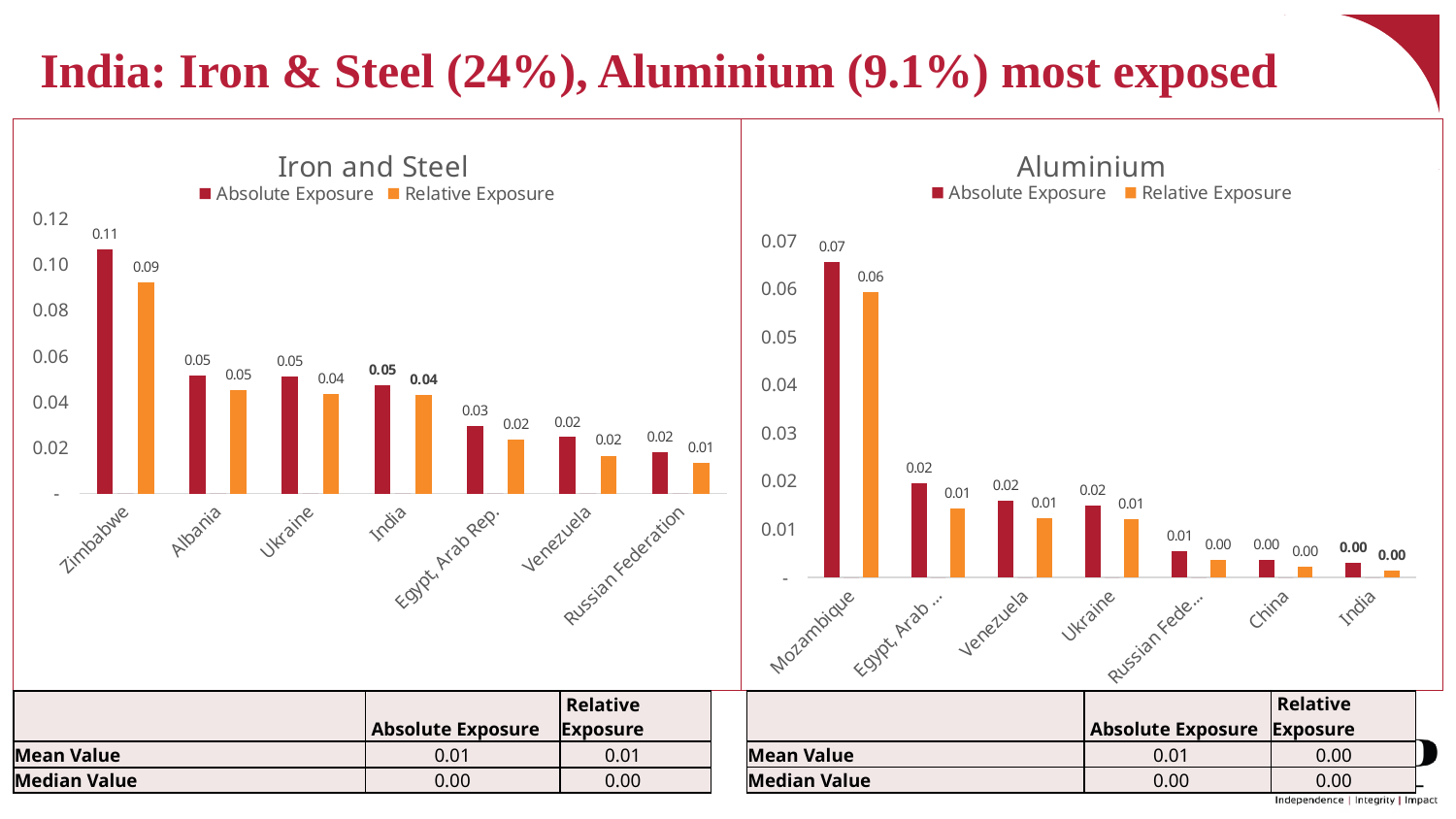
In the Aluminium chart, which is larger: Mozambique's Absolute Exposure or Egypt's Absolute Exposure? Mozambique's Absolute Exposure In the Iron and Steel chart, which country has the lowest Relative Exposure? Russian Federation In the Aluminium chart, what is the Relative Exposure value for Ukraine? 0.01 In the Iron and Steel chart, is the Absolute Exposure value for Zimbabwe greater or less than 0.10? greater In the Aluminium chart, what is the Absolute Exposure value for Mozambique? 0.07 In the Iron and Steel chart, what is the Absolute Exposure value for Zimbabwe? 0.11 How many countries are shown on the x axis of the Aluminium chart? 7 In the Iron and Steel chart, what is the difference between Zimbabwe's Absolute Exposure and its Relative Exposure? 0.02 In the Iron and Steel chart, which country has the highest Absolute Exposure? Zimbabwe In the Iron and Steel chart, what is the Relative Exposure value for India? 0.04 How many series does the legend of the Iron and Steel chart list? 2 What kind of chart is the Aluminium chart? Bar chart